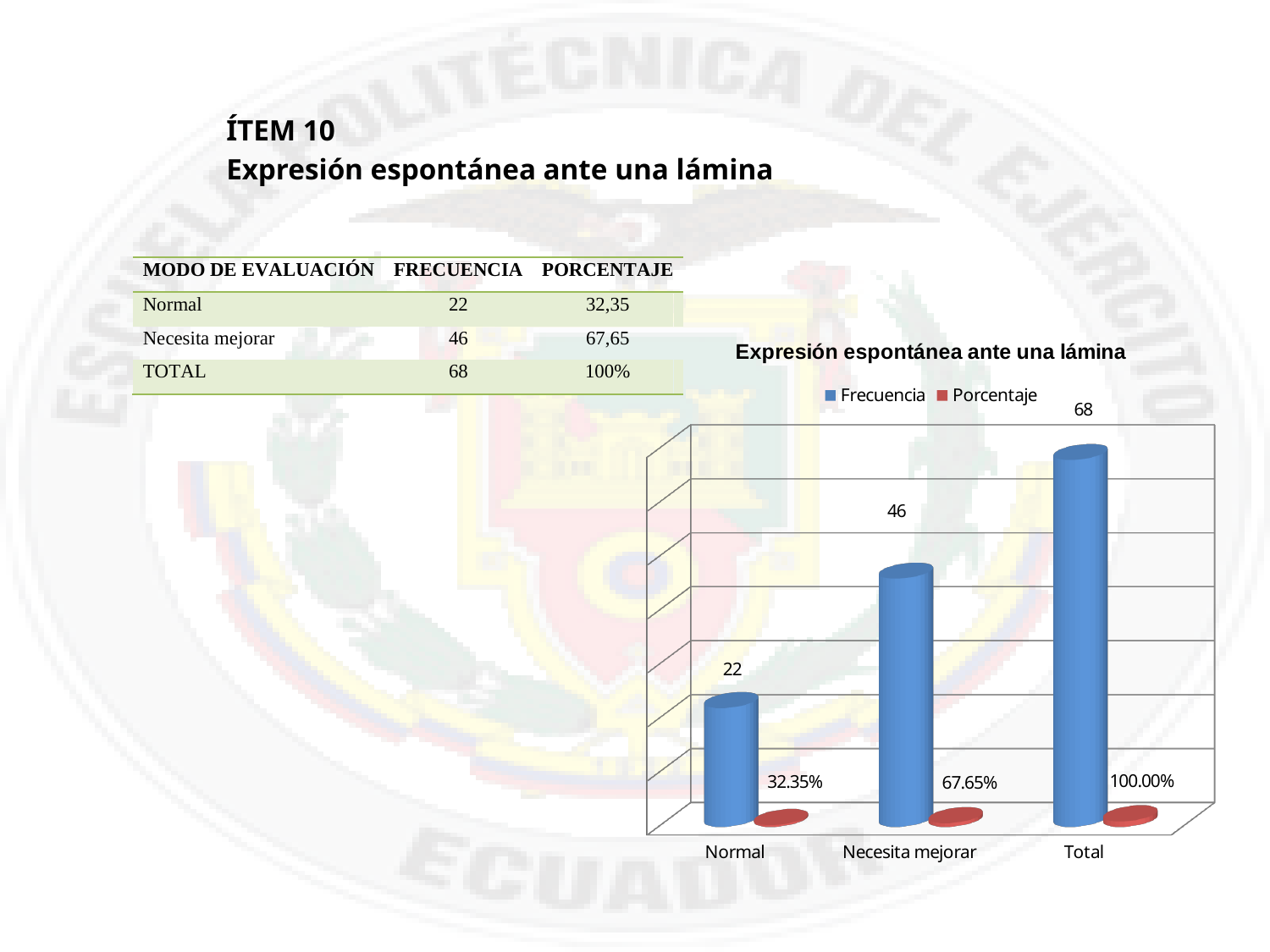
What is the Frecuencia value for Total? 68 Which category has the lowest Frecuencia value? Normal What is the Frecuencia value for Normal? 22 How many categories are shown on the x axis of the chart? 3 Which category has the highest Frecuencia value? Total What is the Porcentaje value for Normal? 32.35% What is the title of the chart? Expresión espontánea ante una lámina What is the difference between the Frecuencia values for Necesita mejorar and Normal? 24 Which has a larger Frecuencia value, Normal or Necesita mejorar? Necesita mejorar What is the Porcentaje value for Necesita mejorar? 67.65% What is the Frecuencia value for Necesita mejorar? 46 How many series does the chart legend list? 2